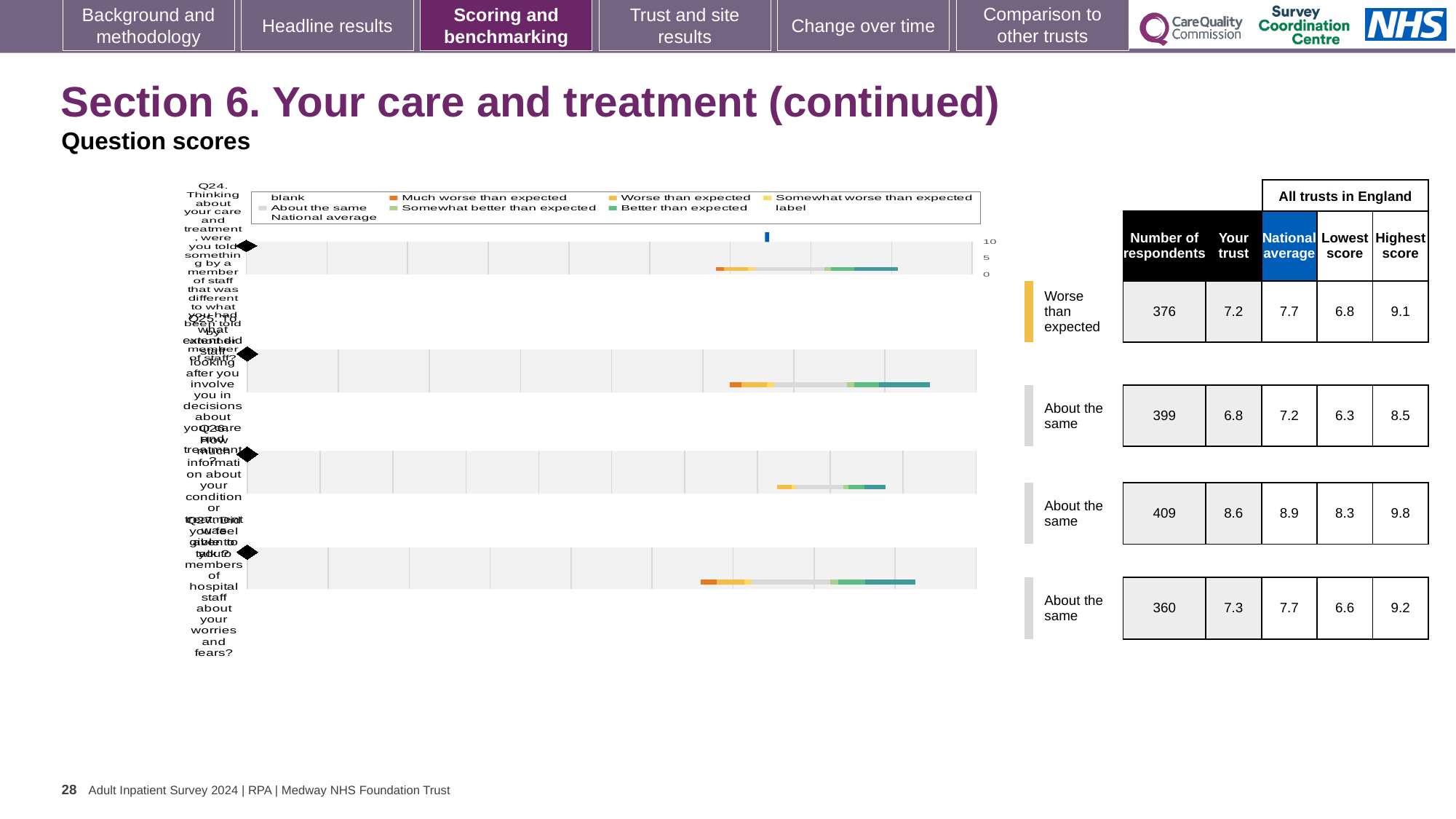
What kind of chart is used to show the question scores? Bar chart What is the difference between the national average and the 'Your trust' score for the first question row (Q24)? 0.5 Which question row has the highest 'Your trust' score? The third row (8.6) For the third question row, which is larger: the 'Your trust' score or the national average? National average How many question rows are plotted on the chart? 4 What benchmark category is shown for the first question row (Q24)? Worse than expected What is the national average score for the first question row (Q24)? 7.7 Which question row has the lowest number of respondents? The fourth row (360) How many respondents are listed for the first question row (Q24) in the table? 376 What is the highest score among all trusts in England for the first question row (Q24)? 9.1 What is the lowest score among all trusts in England for the second question row? 6.3 What is the 'Your trust' score for the first question row (Q24)? 7.2